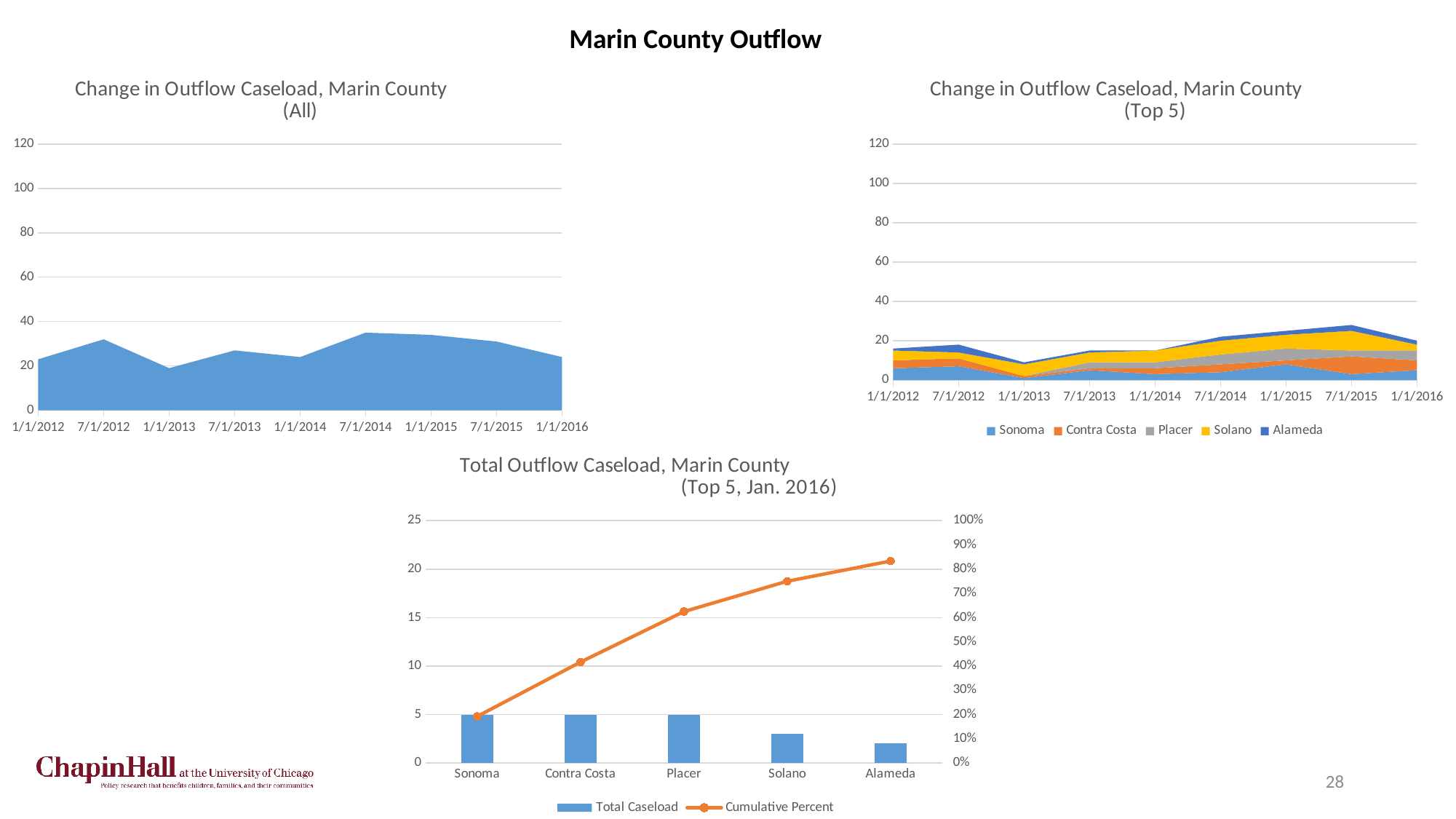
In the chart titled 'Total Outflow Caseload, Marin County (Top 5, Jan. 2016)', which has the larger Total Caseload, Solano or Alameda? Solano In the chart titled 'Total Outflow Caseload, Marin County (Top 5, Jan. 2016)', is the Cumulative Percent for Placer greater or less than 50%? greater In the chart titled 'Total Outflow Caseload, Marin County (Top 5, Jan. 2016)', what is the Total Caseload for Placer? 5 In the chart titled 'Change in Outflow Caseload, Marin County (Top 5)', which series is shown in yellow? Solano In the chart titled 'Total Outflow Caseload, Marin County (Top 5, Jan. 2016)', which county has the lowest Total Caseload? Alameda How many series does the legend list in the chart titled 'Change in Outflow Caseload, Marin County (Top 5)'? 5 How many counties are shown on the x axis of the chart titled 'Total Outflow Caseload, Marin County (Top 5, Jan. 2016)'? 5 In the chart titled 'Total Outflow Caseload, Marin County (Top 5, Jan. 2016)', what is the Total Caseload for Sonoma? 5 In the chart titled 'Total Outflow Caseload, Marin County (Top 5, Jan. 2016)', is the Total Caseload for Solano greater or less than 5? less How many dates are shown on the x axis of the chart titled 'Change in Outflow Caseload, Marin County (All)'? 9 In the chart titled 'Change in Outflow Caseload, Marin County (All)', is the value for 7/1/2012 greater or less than 20? greater In the chart titled 'Total Outflow Caseload, Marin County (Top 5, Jan. 2016)', does the Cumulative Percent line rise or fall from Sonoma to Alameda? rise